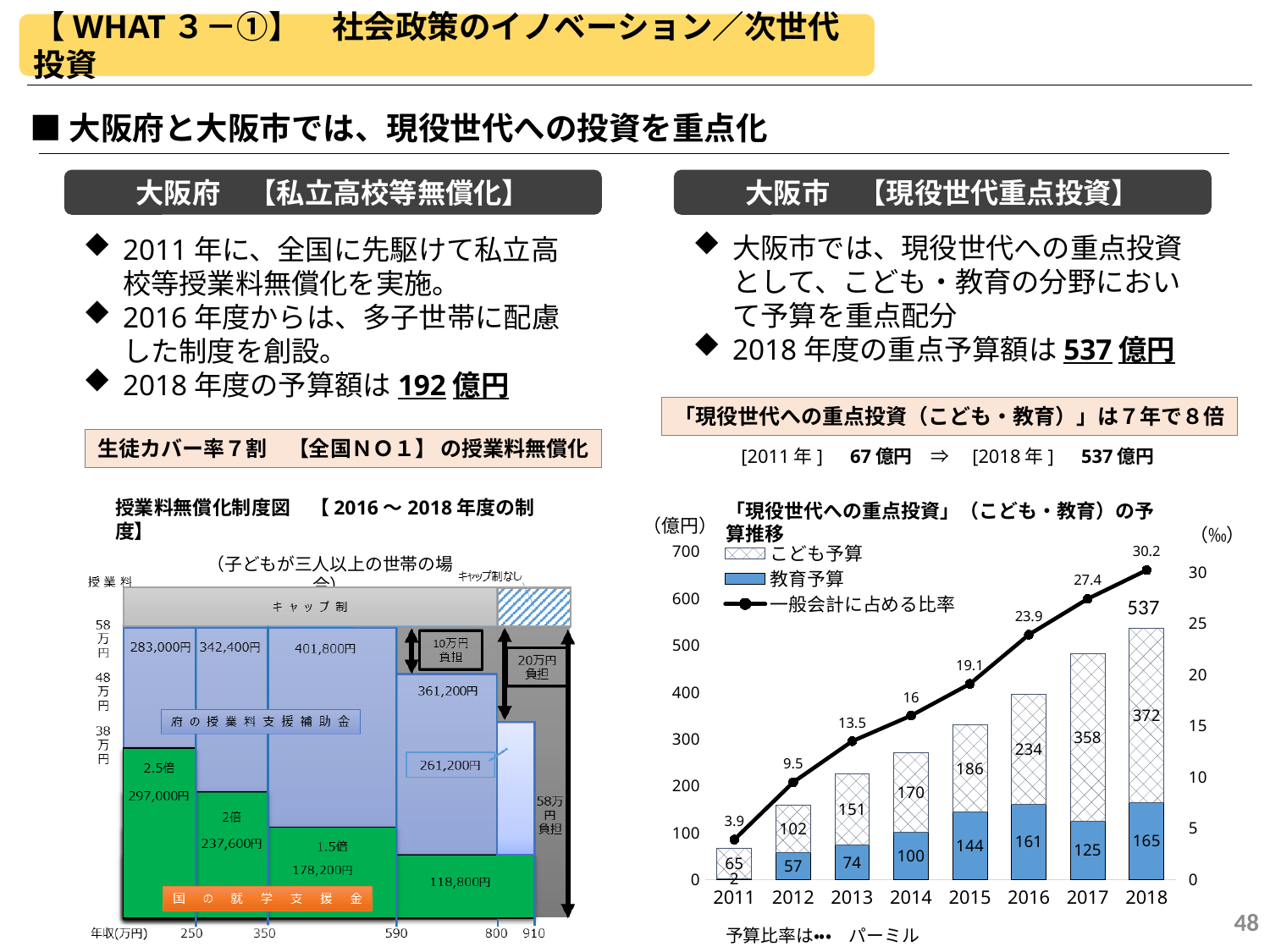
In the chart 「現役世代への重点投資」（こども・教育）の予算推移, how many years are shown on the x axis? 8 In the chart 「現役世代への重点投資」（こども・教育）の予算推移, which year has the lowest こども予算? 2011 In the chart 「現役世代への重点投資」（こども・教育）の予算推移, what is the total of the stacked bar for 2014? 270 In the chart 「現役世代への重点投資」（こども・教育）の予算推移, does the 一般会計に占める比率 line rise or fall from 2011 to 2018? rise In the chart 「現役世代への重点投資」（こども・教育）の予算推移, which year has the highest 一般会計に占める比率? 2018 In the chart 「現役世代への重点投資」（こども・教育）の予算推移, what is the difference between the こども予算 values for 2017 and 2016? 124 In the chart 「現役世代への重点投資」（こども・教育）の予算推移, which is larger, the 教育予算 for 2016 or for 2017? 2016 In the chart 「現役世代への重点投資」（こども・教育）の予算推移, what is the こども予算 value for 2018? 372 In the chart 「現役世代への重点投資」（こども・教育）の予算推移, how many series does the legend list? 3 In the chart 「現役世代への重点投資」（こども・教育）の予算推移, what is the 教育予算 value for 2015? 144 In the chart 「現役世代への重点投資」（こども・教育）の予算推移, what is the 一般会計に占める比率 value for 2013? 13.5 In the chart 「現役世代への重点投資」（こども・教育）の予算推移, what is the total of the stacked bar for 2018? 537